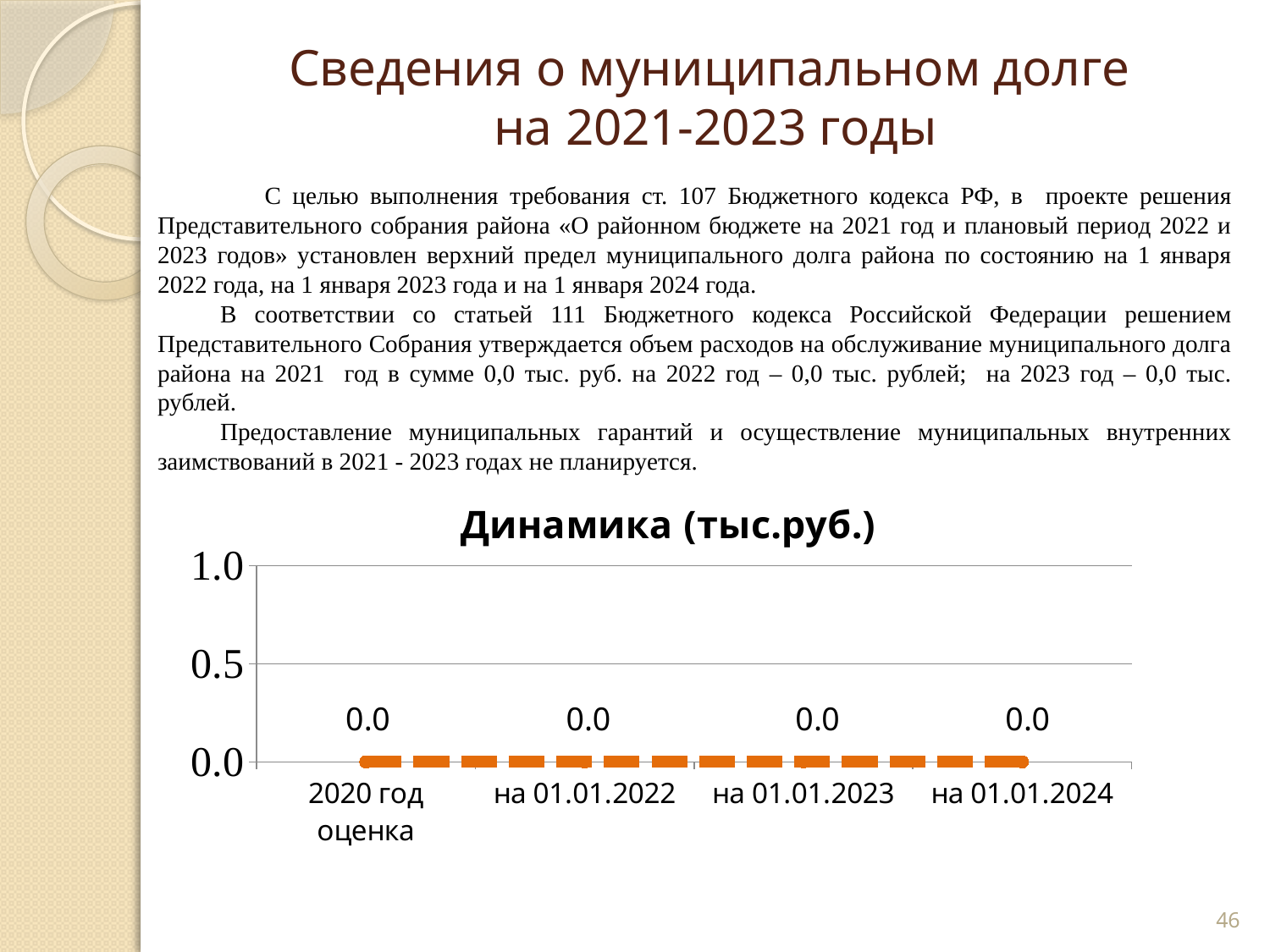
What is the title of the chart on the slide? Динамика (тыс.руб.) What kind of chart is the Динамика (тыс.руб.) chart? line chart Do the values in the Динамика (тыс.руб.) chart rise, fall or stay flat from 2020 год оценка to на 01.01.2024? stay flat What is the value for 2020 год оценка in the Динамика (тыс.руб.) chart? 0.0 What is the value for на 01.01.2023 in the Динамика (тыс.руб.) chart? 0.0 How many data points are plotted in the Динамика (тыс.руб.) chart? 4 What is the highest tick value shown on the vertical axis of the Динамика (тыс.руб.) chart? 1.0 Is the value for на 01.01.2023 in the Динамика (тыс.руб.) chart greater or less than 0.5? less What is the value for на 01.01.2024 in the Динамика (тыс.руб.) chart? 0.0 What is the value for на 01.01.2022 in the Динамика (тыс.руб.) chart? 0.0 What is the difference between the values for на 01.01.2024 and 2020 год оценка in the Динамика (тыс.руб.) chart? 0.0